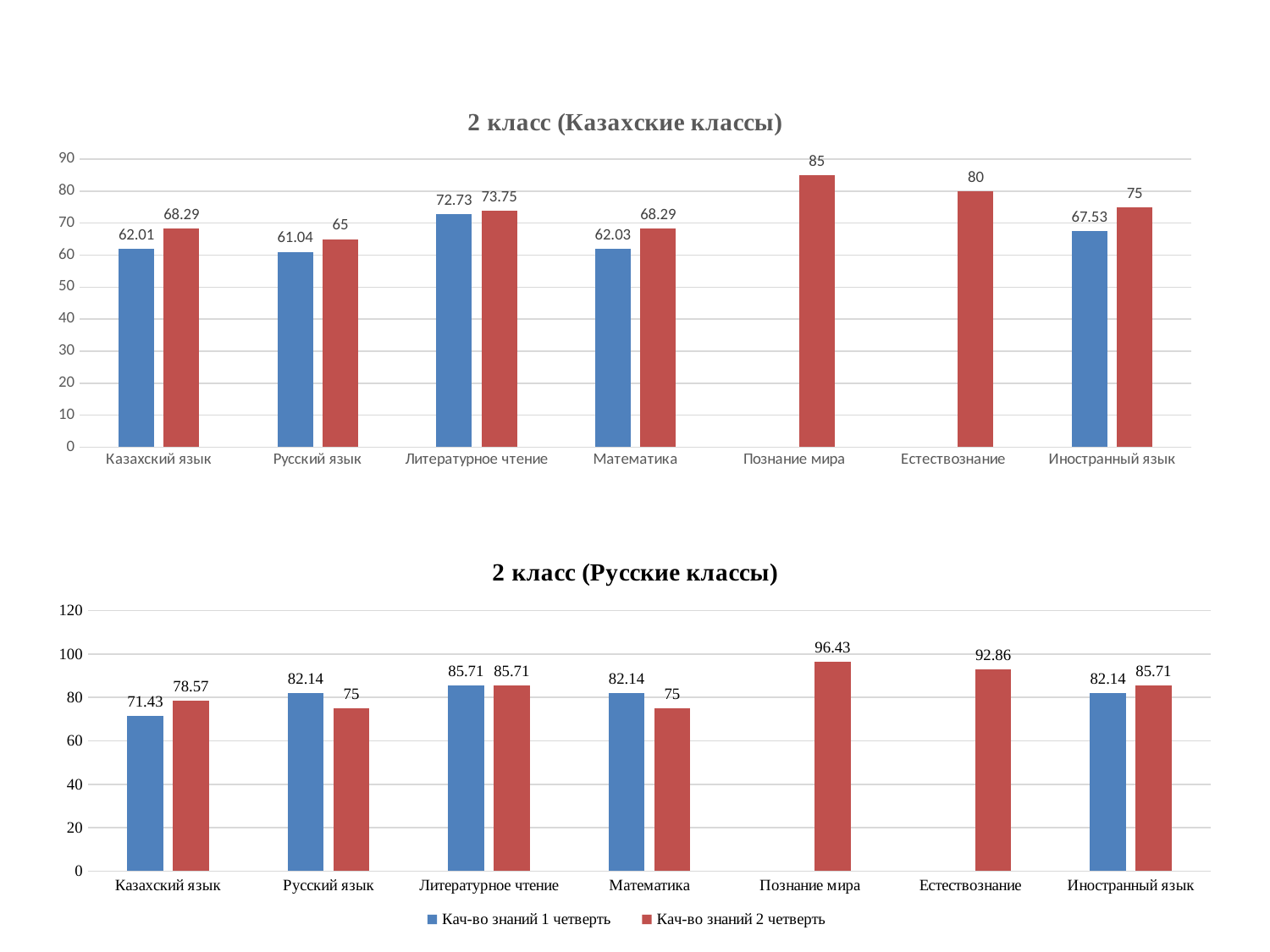
In the chart titled "2 класс (Казахские классы)", how many categories are shown on the x axis? 7 In the chart titled "2 класс (Казахские классы)", what is the value of the red bar for Математика? 68.29 How many series does the legend of the chart titled "2 класс (Русские классы)" list? 2 In the chart titled "2 класс (Казахские классы)", what is the difference between the red and blue bars for Казахский язык? 6.28 In the chart titled "2 класс (Казахские классы)", which category has the highest red bar? Познание мира In the chart titled "2 класс (Казахские классы)", which category has the lowest blue bar? Русский язык In the chart titled "2 класс (Казахские классы)", what is the value of the blue bar for Литературное чтение? 72.73 In the chart titled "2 класс (Русские классы)", which is larger for Русский язык: Кач-во знаний 1 четверть or Кач-во знаний 2 четверть? Кач-во знаний 1 четверть In the chart titled "2 класс (Русские классы)", what is the value for Кач-во знаний 2 четверть for Познание мира? 96.43 In the chart titled "2 класс (Русские классы)", what is the difference between Кач-во знаний 2 четверть and Кач-во знаний 1 четверть for Математика? 7.14 What type of chart is the chart titled "2 класс (Русские классы)"? Bar chart In the chart titled "2 класс (Русские классы)", what is the value for Кач-во знаний 1 четверть for Казахский язык? 71.43